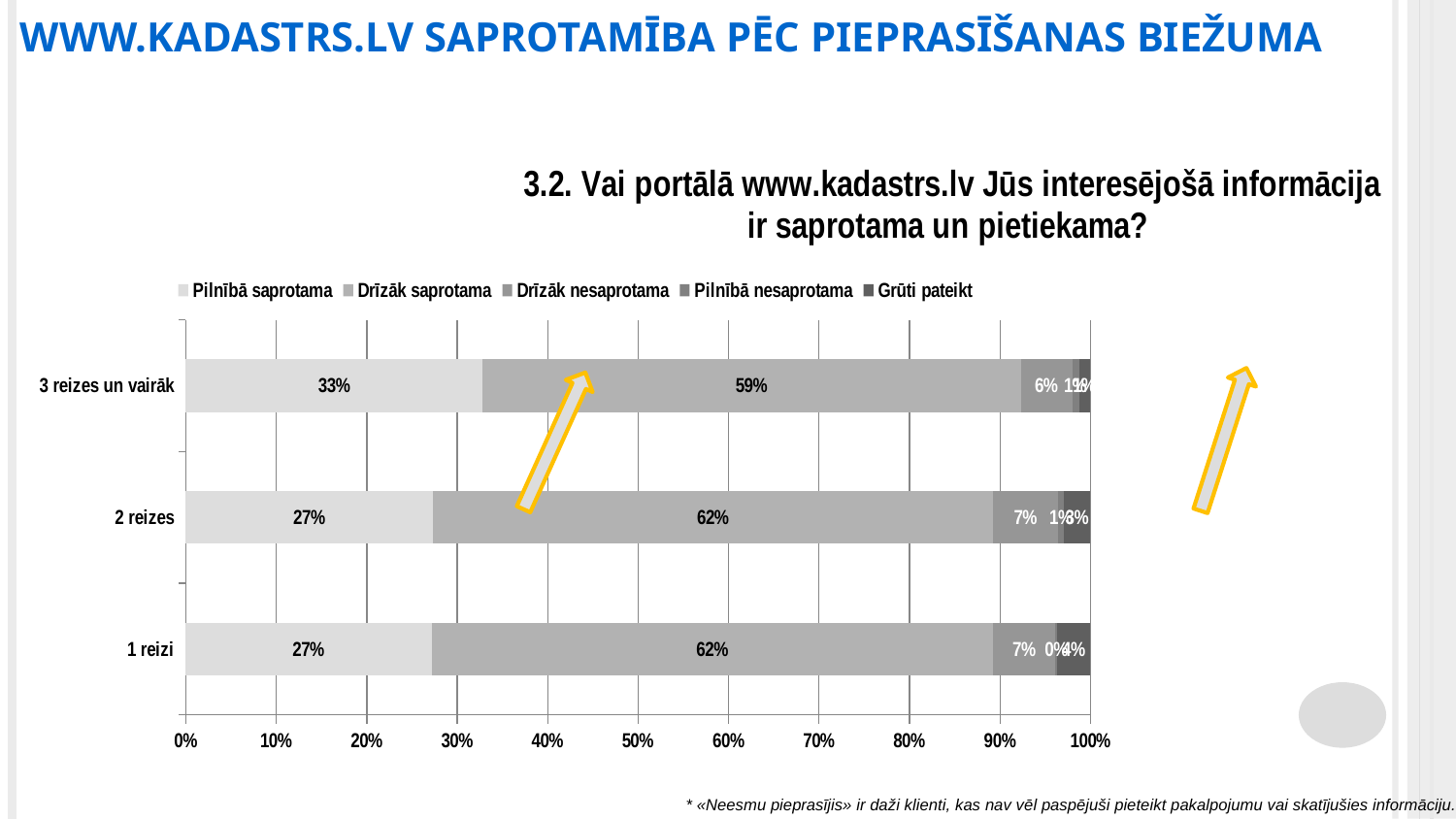
How many series does the chart legend list? 5 Which category has the highest value for "Pilnībā saprotama"? 3 reizes un vairāk What is the first entry in the chart legend? Pilnībā saprotama What is the value of "Pilnībā saprotama" for "1 reizi"? 27% Which has the larger "Drīzāk saprotama" value: "3 reizes un vairāk" or "1 reizi"? 1 reizi What kind of chart is shown on the slide? Stacked bar chart What is the value of "Drīzāk saprotama" for "2 reizes"? 62% What is the difference between the "Pilnībā saprotama" values for "3 reizes un vairāk" and "2 reizes"? 6 percentage points How many categories (request-frequency groups) are shown on the y axis of the chart? 3 What is the value of "Drīzāk nesaprotama" for "1 reizi"? 7% What is the value of "Pilnībā saprotama" for "3 reizes un vairāk"? 33% What is the value of "Drīzāk nesaprotama" for "3 reizes un vairāk"? 6%